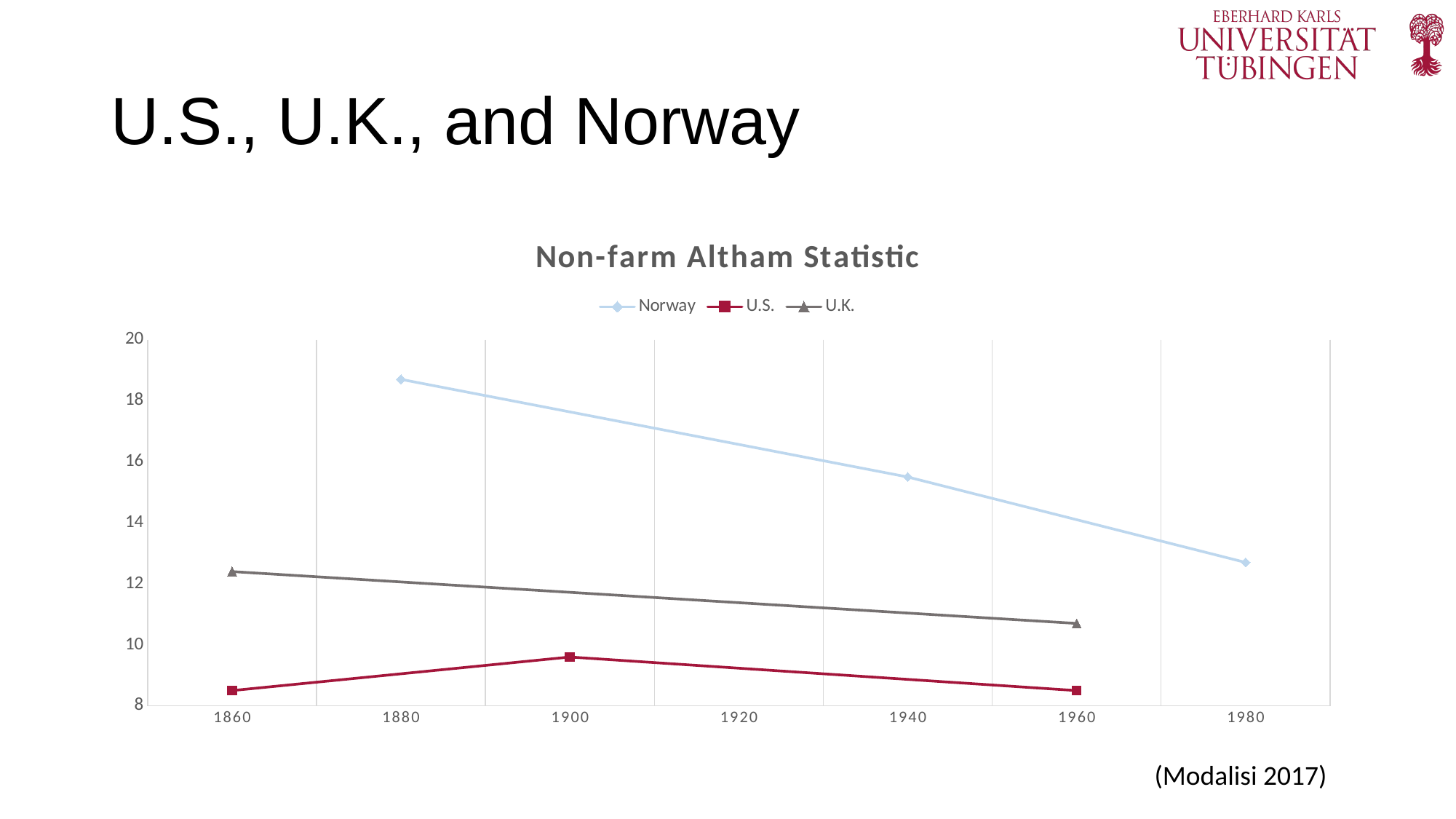
Which series has the highest value on the chart? Norway How many data points are plotted for Norway? 3 Which is larger: the value for Norway in 1940 or the value for the U.K. in 1960? Norway in 1940 Do the values for Norway rise or fall from 1880 to 1980? fall How many series does the legend list? 3 What is the title of the chart? Non-farm Altham Statistic What kind of chart is shown on the slide? line chart Is the value for the U.S. in 1900 greater or less than 10? less Is the value for Norway in 1980 greater or less than 14? less Which series has the lowest values on the chart? U.S. Is the value for the U.K. in 1860 greater or less than 12? greater